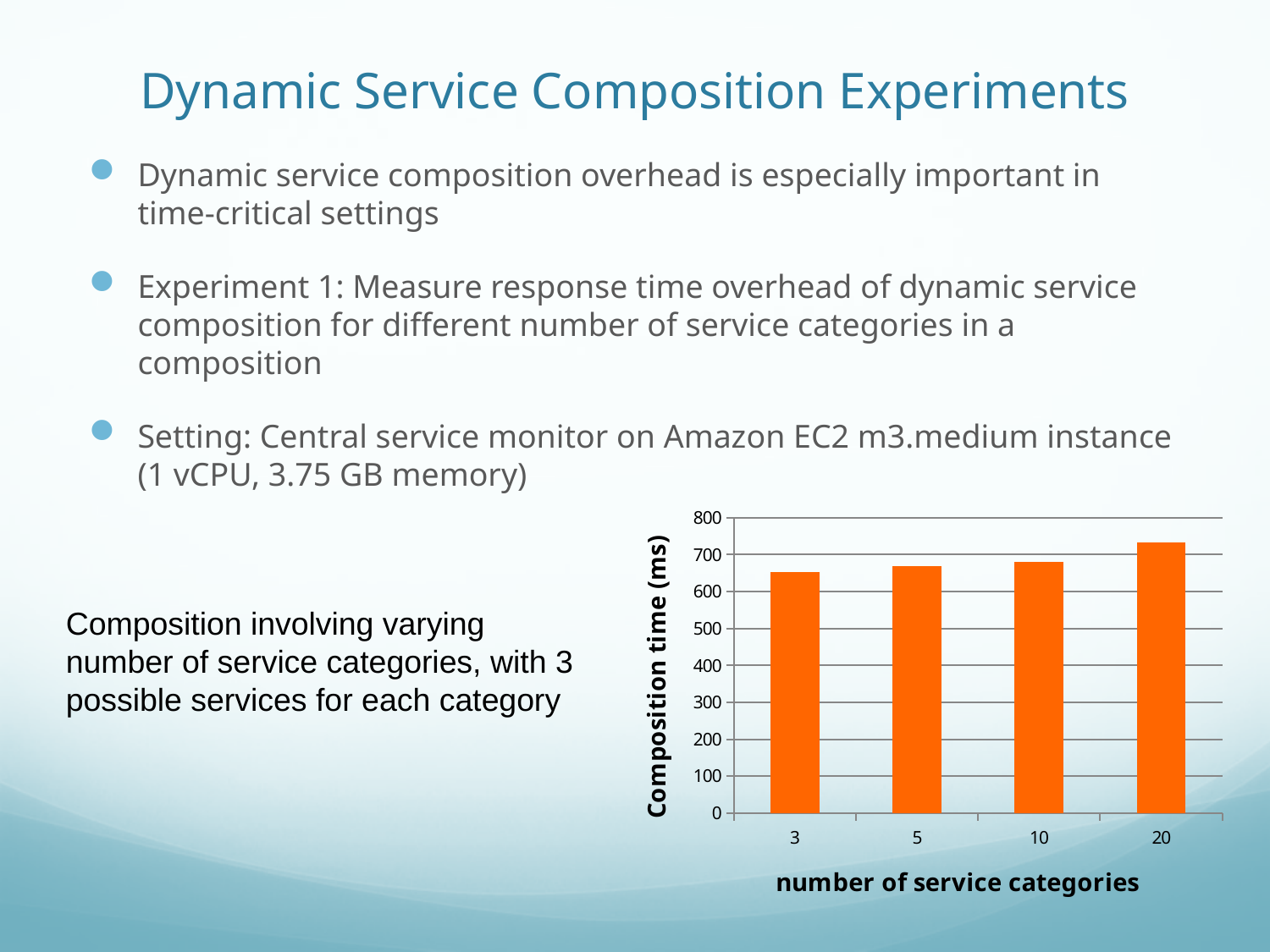
Is the composition time for 10 service categories greater or less than 600? greater Is the composition time for 3 service categories greater or less than 600? greater How many bars (numbers of service categories) are plotted in the chart? 4 What is the label of the y axis of the chart? Composition time (ms) What is the label of the x axis of the chart? number of service categories Which has a larger composition time: 3 service categories or 20 service categories? 20 What kind of chart is shown on the slide? bar chart Is the composition time for 20 service categories greater or less than 700? greater Does the composition time rise or fall as the number of service categories increases along the x axis? rise Which number of service categories has the highest composition time? 20